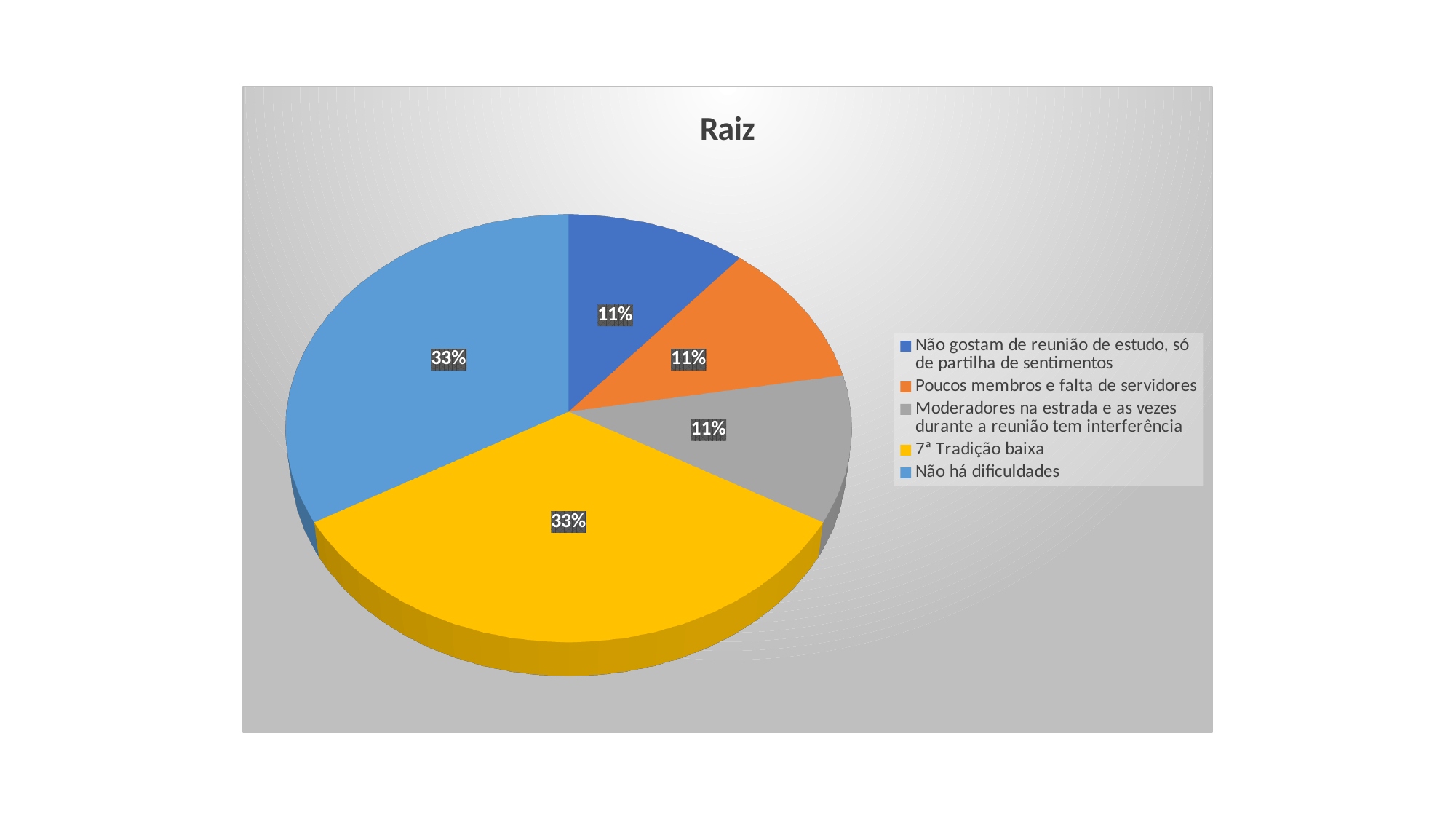
What is the title of the chart? Raiz What kind of chart is shown on the slide? pie chart Which is larger, the slice for "7ª Tradição baixa" or the slice for "Poucos membros e falta de servidores"? 7ª Tradição baixa How many slices does the pie chart have? 5 What colour is the slice for "7ª Tradição baixa"? yellow What share of the pie is labelled "Não gostam de reunião de estudo, só de partilha de sentimentos"? 11% What share of the pie is labelled "Não há dificuldades"? 33% What is the difference between the share for "Não há dificuldades" and the share for "Moderadores na estrada e as vezes durante a reunião tem interferência"? 22% What share of the pie is labelled "Poucos membros e falta de servidores"? 11% How many entries does the legend list? 5